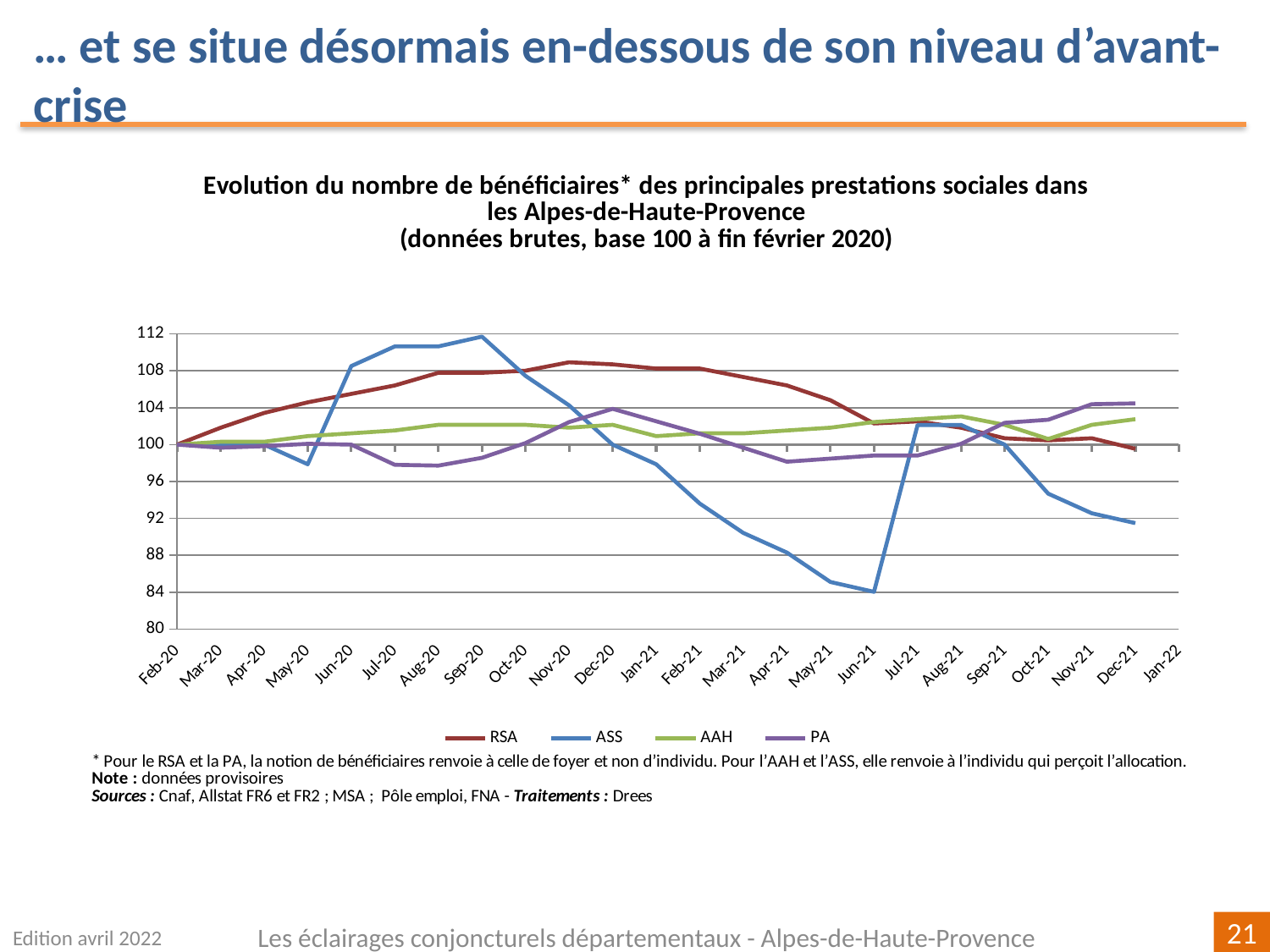
How many series does the legend list? 4 What kind of chart is shown on the slide? line chart Is the value for ASS in Jun-21 greater or less than 88? less Which series reaches the highest value anywhere on the chart? ASS Is the value for ASS in Sep-20 greater or less than 108? greater Is the value for AAH in Dec-21 greater or less than 100? greater In Jun-21, which is larger, the value for RSA or the value for ASS? RSA Which series falls to the lowest value anywhere on the chart? ASS Which series are listed in the legend? RSA, ASS, AAH, PA Does the ASS series rise or fall between Sep-20 and Jun-21? fall How many month labels are shown on the x axis? 24